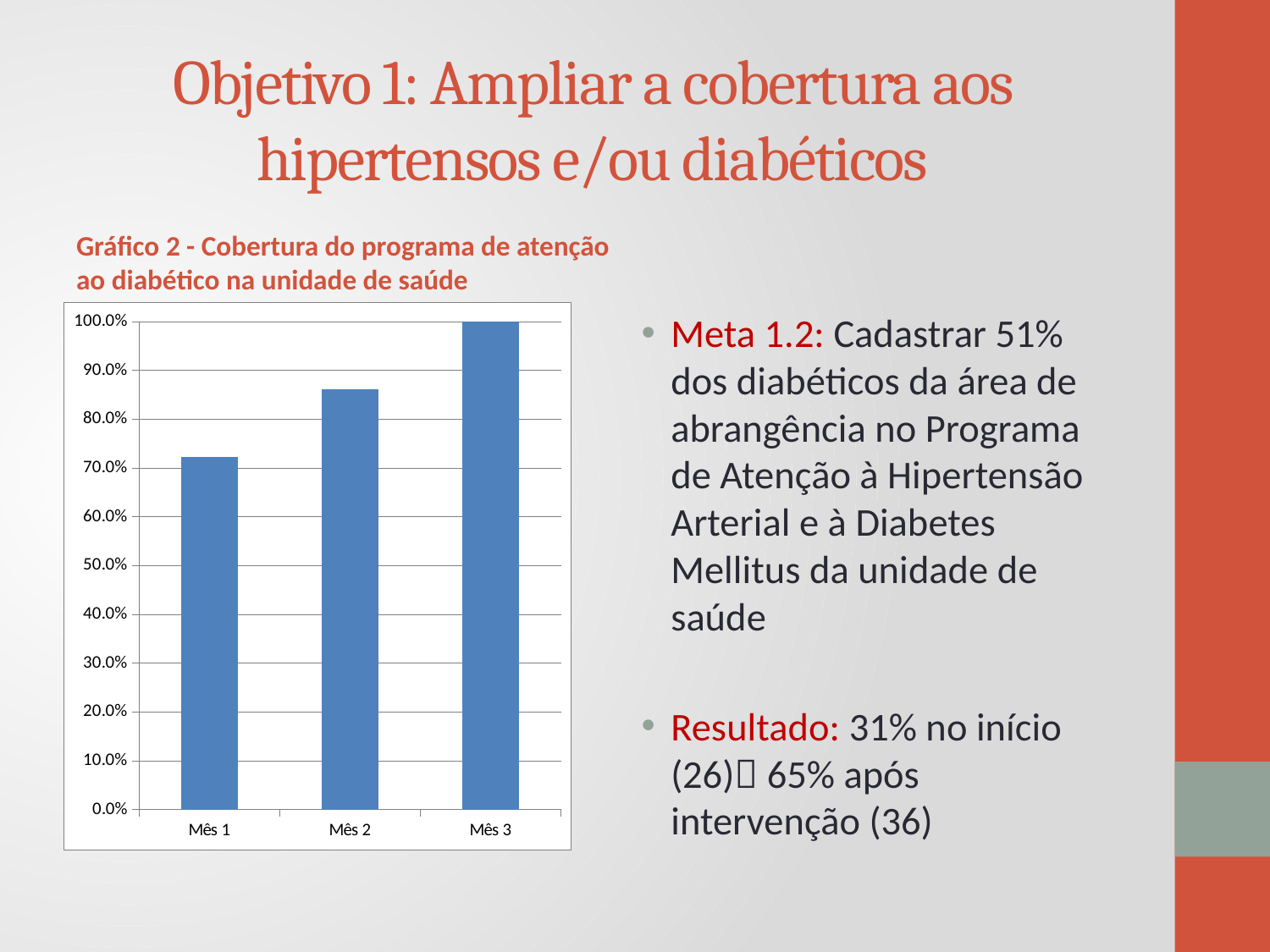
How many categories (months) are plotted on the chart? 3 Which month has the lowest bar on the chart? Mês 1 What is the value for Mês 3 on the chart? 100.0% What kind of chart is shown on the slide? bar chart What is the title of the chart on the slide? Gráfico 2 - Cobertura do programa de atenção ao diabético na unidade de saúde Is the value for Mês 2 greater or less than 90.0%? less Is the value for Mês 1 greater or less than 80.0%? less Is the value for Mês 1 greater or less than 70.0%? greater Which is larger, the value for Mês 1 or the value for Mês 2? Mês 2 Which month has the highest bar on the chart? Mês 3 Do the values rise or fall from Mês 1 to Mês 3? rise